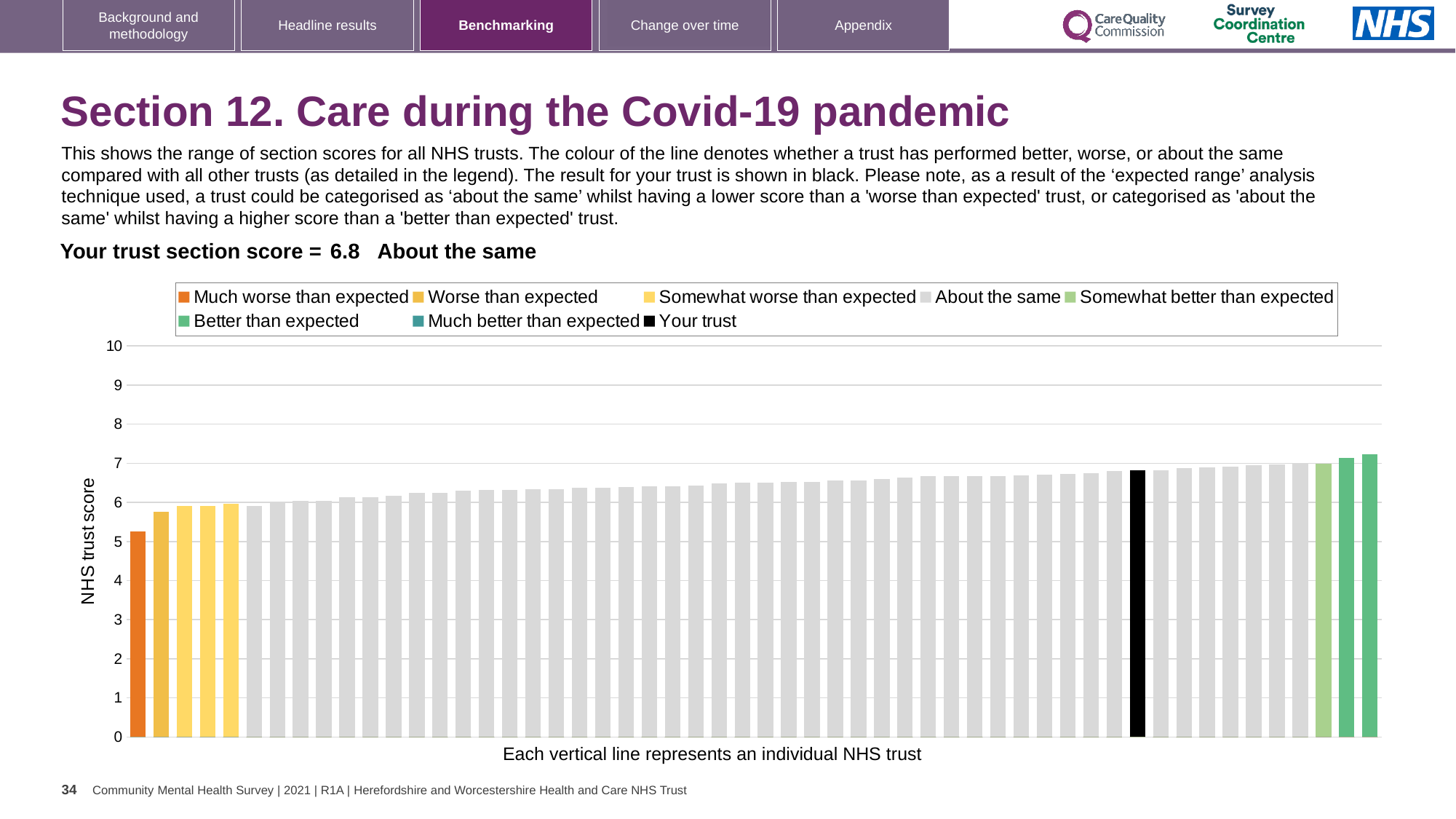
What kind of chart is shown on the slide? Bar chart Is the value for your trust (the black bar) greater or less than 6? greater Which is larger: the black 'Your trust' bar or the orange 'Much worse than expected' bar? Your trust Is the value of the tallest bar on the chart greater or less than 6? greater Which performance category is your trust placed in for this section? About the same Do the bar values rise or fall from left to right along the x axis? Rise Which legend category does the lowest bar on the chart belong to? Much worse than expected What is the label on the vertical axis of the chart? NHS trust score Is the value of the orange 'Much worse than expected' bar greater or less than 6? less What is the section score for your trust shown on the slide? 6.8 How many entries does the chart legend list? 8 Which legend category does the highest bar on the chart belong to? Better than expected